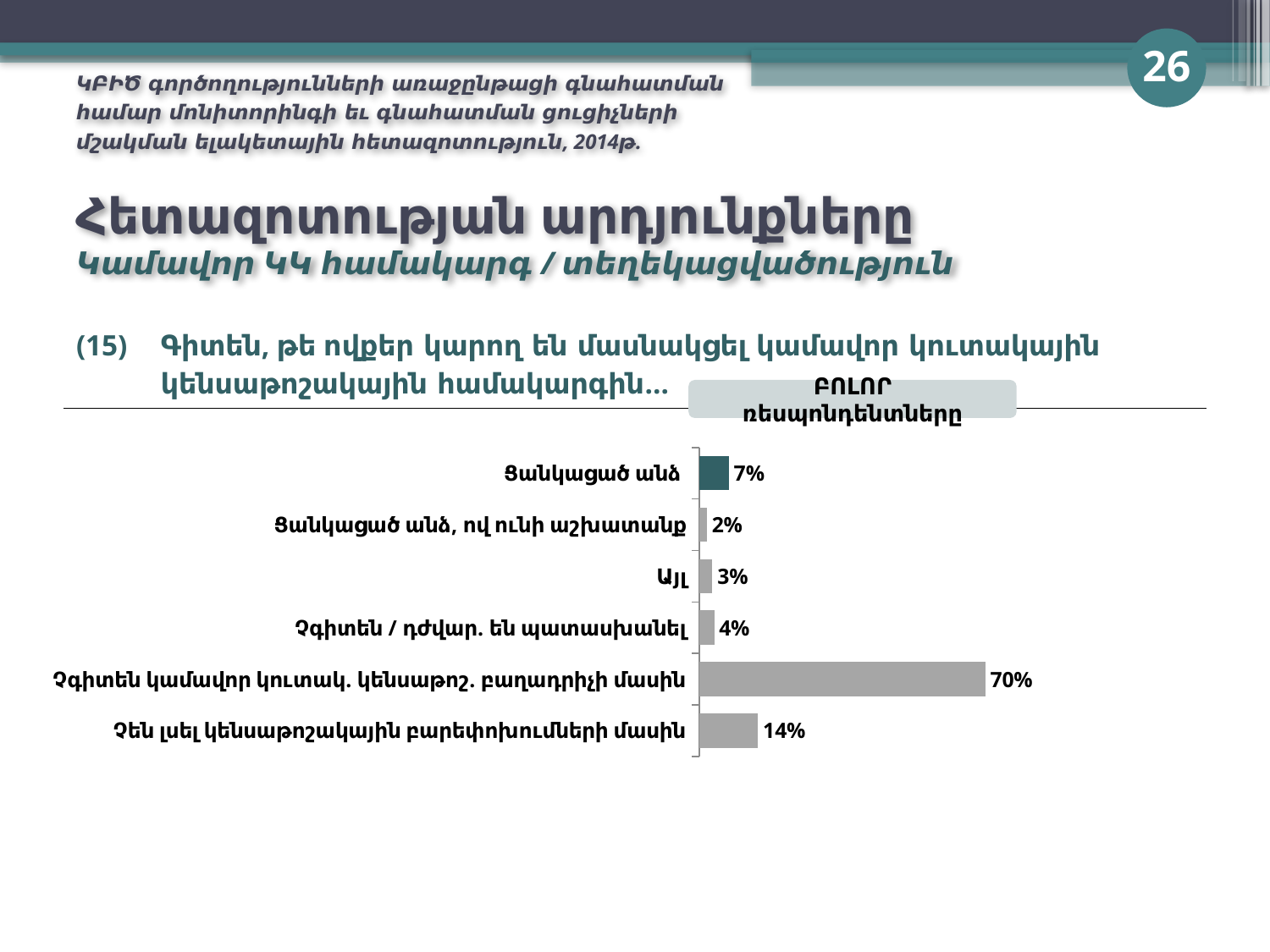
Which category has the lowest value? Ցանկացած անձ, ով ունի աշխատանք Which category has the highest value? Չգիտեն կամավոր կուտակ. կենսաթոշ. բաղադրիչի մասին Which is larger, the value for "Ցանկացած անձ" or the value for "Չգիտեն / դժվար. են պատասխանել"? Ցանկացած անձ What type of chart is shown on the slide? Bar chart What is the value for "Չեն լսել կենսաթոշակային բարեփոխումների մասին"? 14% What is the header text shown above the chart bars? ԲՈԼՈՐ ռեսպոնդենտները What is the value for "Այլ"? 3% What is the value for "Ցանկացած անձ, ով ունի աշխատանք"? 2% What is the value for "Չգիտեն / դժվար. են պատասխանել"? 4% What is the value for "Ցանկացած անձ"? 7% How many categories are shown in the chart? 6 What is the difference between the values for "Չգիտեն կամավոր կուտակ. կենսաթոշ. բաղադրիչի մասին" and "Չեն լսել կենսաթոշակային բարեփոխումների մասին"? 56%